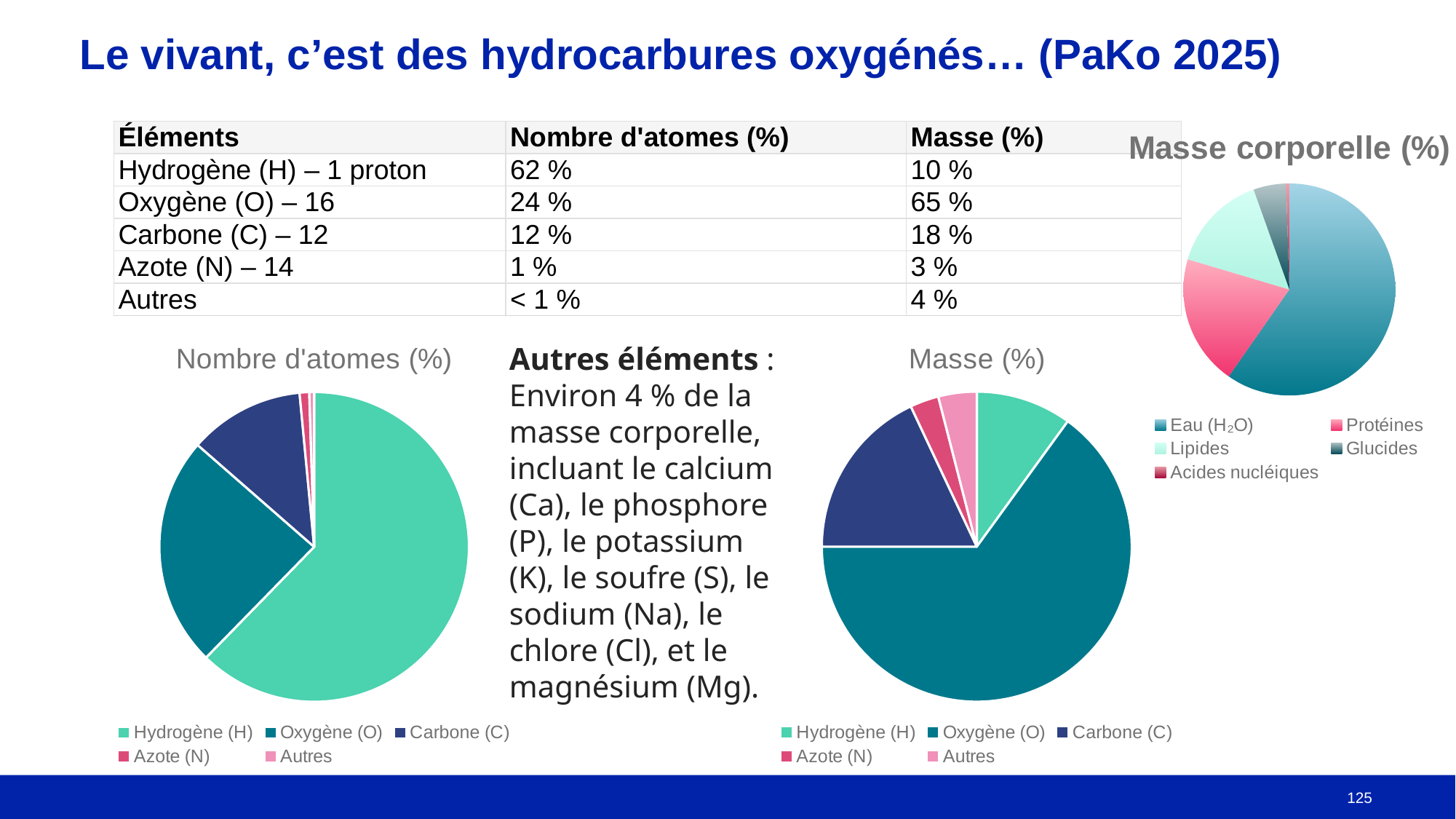
What kind of chart is the "Nombre d'atomes (%)" chart? pie chart In the "Masse (%)" chart, what is the difference between the shares of Oxygène (O) and Carbone (C)? 47 % In the "Masse (%)" chart, which element has the largest slice? Oxygène (O) How many categories does the legend of the "Masse corporelle (%)" chart list? 5 In the "Masse (%)" chart, what share does Oxygène (O) have? 65 % In the "Nombre d'atomes (%)" chart, what share does Carbone (C) have? 12 % In the "Nombre d'atomes (%)" chart, what share does Hydrogène (H) have? 62 % What colour is the Protéines slice in the "Masse corporelle (%)" chart? pink In the "Nombre d'atomes (%)" chart, which element has the largest slice? Hydrogène (H) In the "Masse (%)" chart, which is larger, the slice for Hydrogène (H) or the slice for Carbone (C)? Carbone (C) How many categories does the legend of the "Nombre d'atomes (%)" chart list? 5 In the "Masse corporelle (%)" chart, which category has the largest slice? Eau (H₂O)